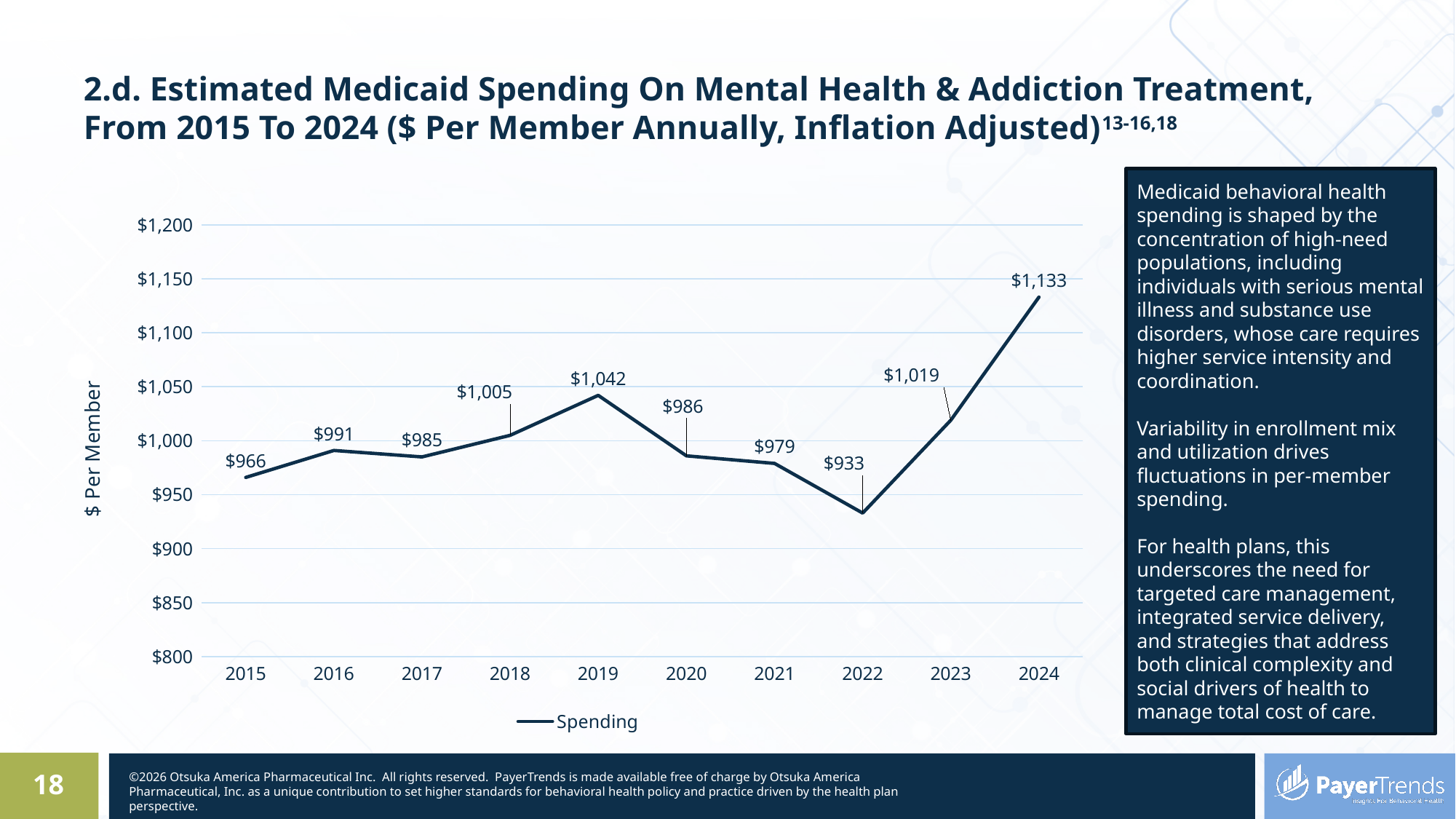
What is the estimated Medicaid spending per member in 2015? $966 What is the difference in spending per member between 2024 and 2023? $114 Which year has the lowest spending per member? 2022 What is the name of the series shown in the legend? Spending What is the estimated Medicaid spending per member in 2022? $933 How many years are plotted on the chart? 10 What is the difference in spending per member between 2019 and 2022? $109 What kind of chart is shown on the slide? Line chart What is the estimated Medicaid spending per member in 2019? $1,042 Is the value for 2021 greater or less than $1,000? less Which year has the highest spending per member? 2024 Which year has higher spending per member, 2016 or 2017? 2016